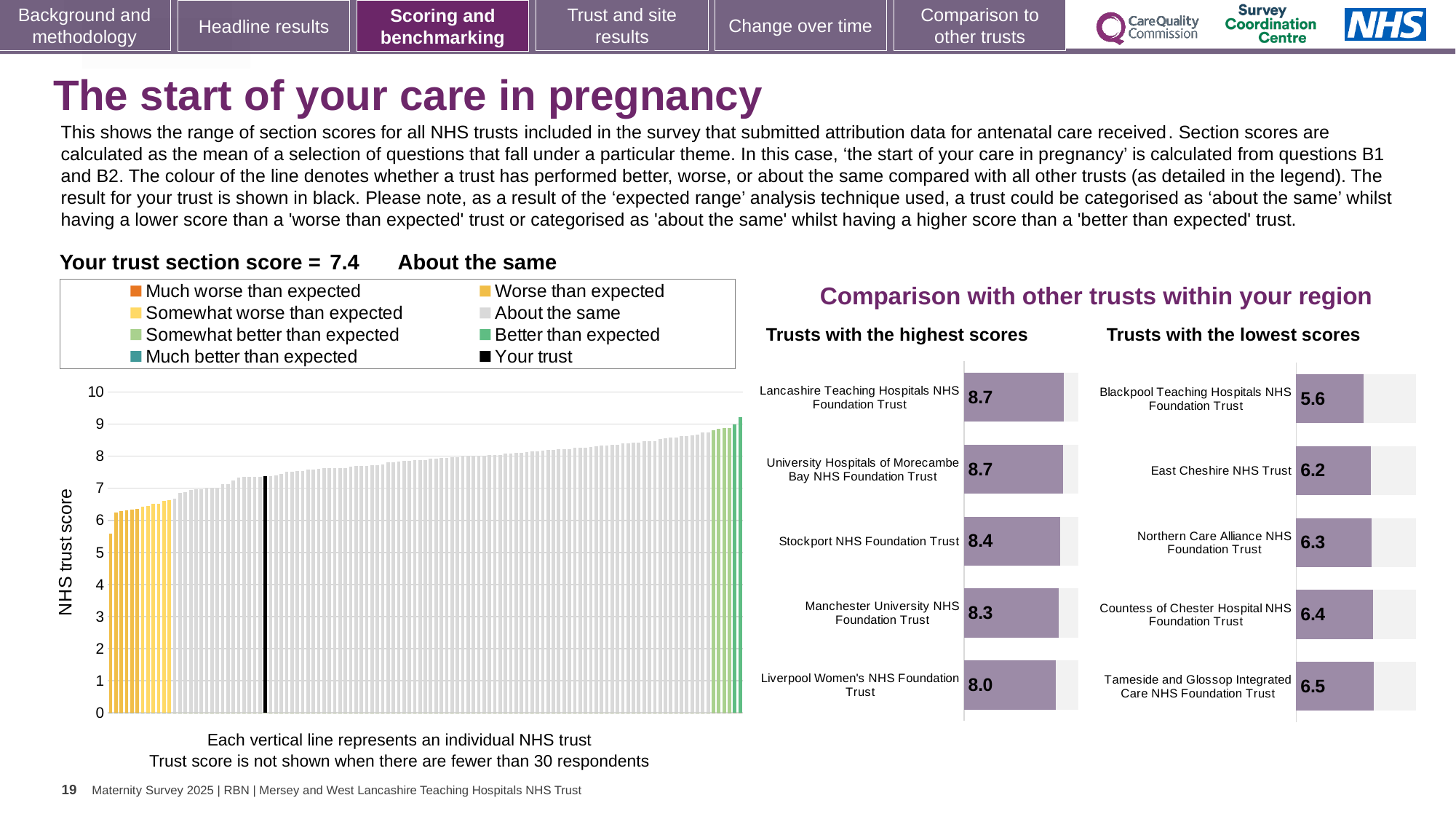
In the main 'NHS trust score' chart on the left, what is the section score for your trust (shown in black)? 7.4 In the 'Trusts with the highest scores' chart, what is the score for Liverpool Women's NHS Foundation Trust? 8.0 In the main 'NHS trust score' chart on the left, do the trust scores rise or fall from left to right? rise How many trusts are shown in the 'Trusts with the lowest scores' chart? 5 In the 'Trusts with the lowest scores' chart, which has the higher score: Northern Care Alliance NHS Foundation Trust or Countess of Chester Hospital NHS Foundation Trust? Countess of Chester Hospital NHS Foundation Trust In the 'Trusts with the highest scores' chart, which trust has the lowest score? Liverpool Women's NHS Foundation Trust In the 'Trusts with the lowest scores' chart, what is the difference between the scores of Tameside and Glossop Integrated Care NHS Foundation Trust and Blackpool Teaching Hospitals NHS Foundation Trust? 0.9 In the 'Trusts with the lowest scores' chart, which trust has the lowest score? Blackpool Teaching Hospitals NHS Foundation Trust What kind of chart is the main 'NHS trust score' chart on the left? bar chart In the 'Trusts with the lowest scores' chart, what is the score for East Cheshire NHS Trust? 6.2 In the 'Trusts with the highest scores' chart, what is the difference between the scores of Stockport NHS Foundation Trust and Manchester University NHS Foundation Trust? 0.1 In the 'Trusts with the highest scores' chart, what is the score for Stockport NHS Foundation Trust? 8.4